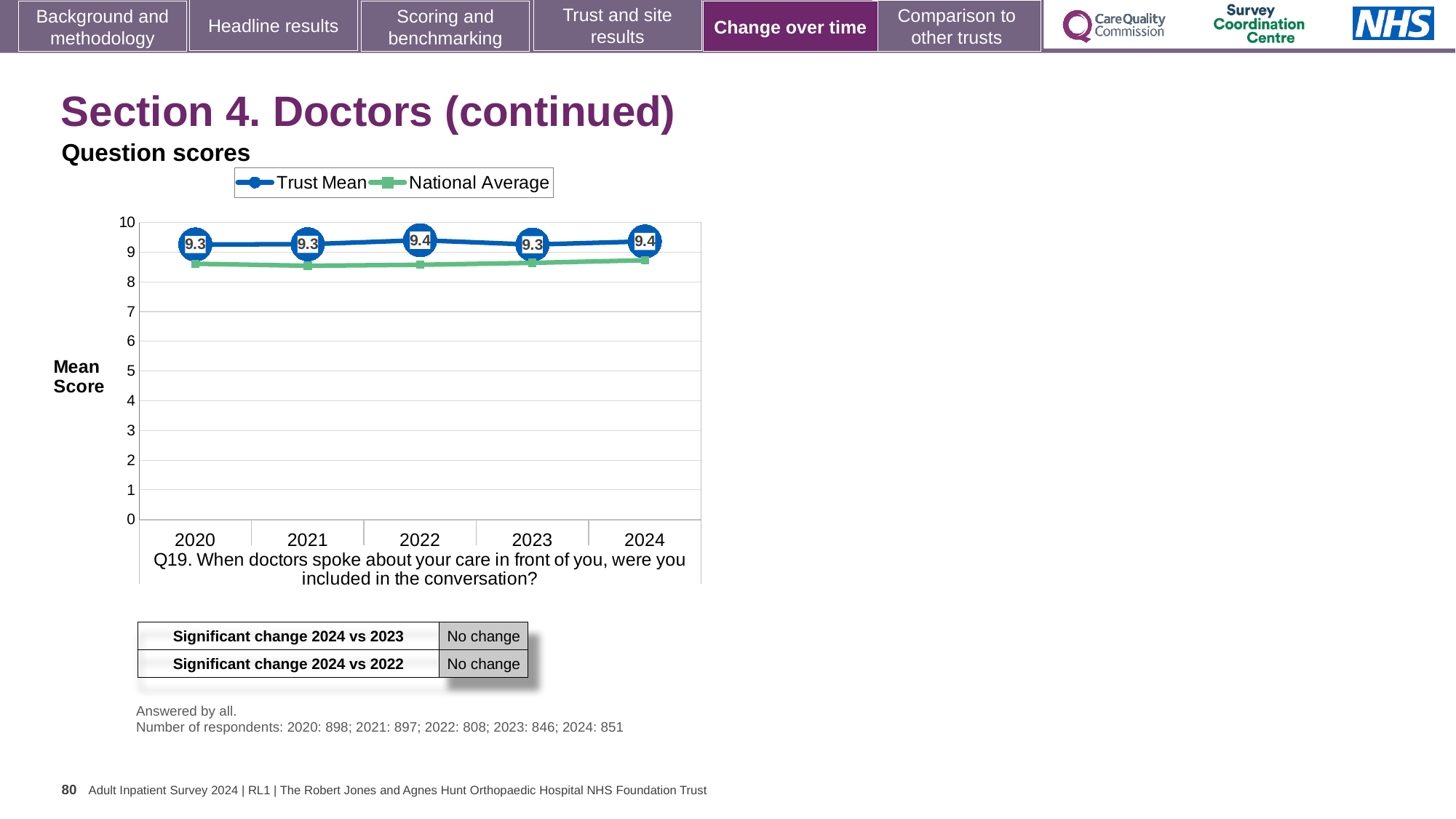
In 2024, which is higher: the Trust Mean or the National Average? Trust Mean How many series does the chart legend list? 2 Is the National Average value for 2021 greater or less than 9? less What is the Trust Mean score for 2023? 9.3 What is the Trust Mean score for 2024? 9.4 What kind of chart is shown on the slide? Line chart What are the two series named in the chart legend? Trust Mean and National Average Is the National Average value for 2024 greater or less than 8? greater How many years are plotted on the x axis of the chart? 5 What is the Trust Mean score for 2022? 9.4 What is the difference between the Trust Mean scores for 2024 and 2020? 0.1 What is the Trust Mean score for 2020? 9.3